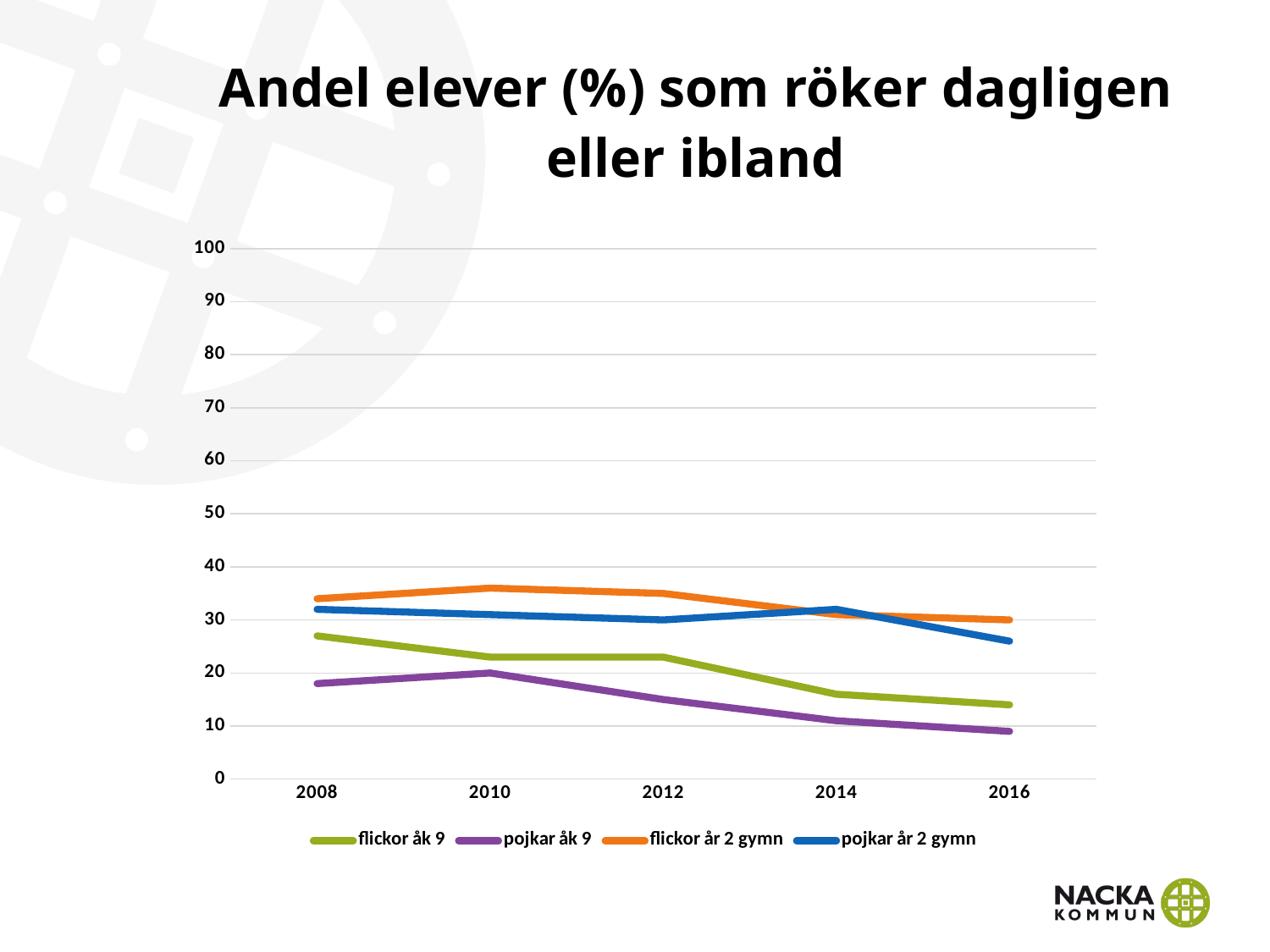
In 2008, which is higher: flickor åk 9 or pojkar åk 9? flickor åk 9 How many series does the legend list? 4 Is the value for flickor åk 9 in 2008 greater or less than 20? greater What kind of chart is shown on the slide? line chart Which series is highest in 2010? flickor år 2 gymn Is the value for pojkar år 2 gymn in 2016 greater or less than 30? less Which series is lowest in 2016? pojkar åk 9 How many years are shown on the x axis? 5 Does the flickor åk 9 series rise or fall from 2008 to 2016? fall Is the value for flickor år 2 gymn in 2010 greater or less than 30? greater What is the title of the chart? Andel elever (%) som röker dagligen eller ibland